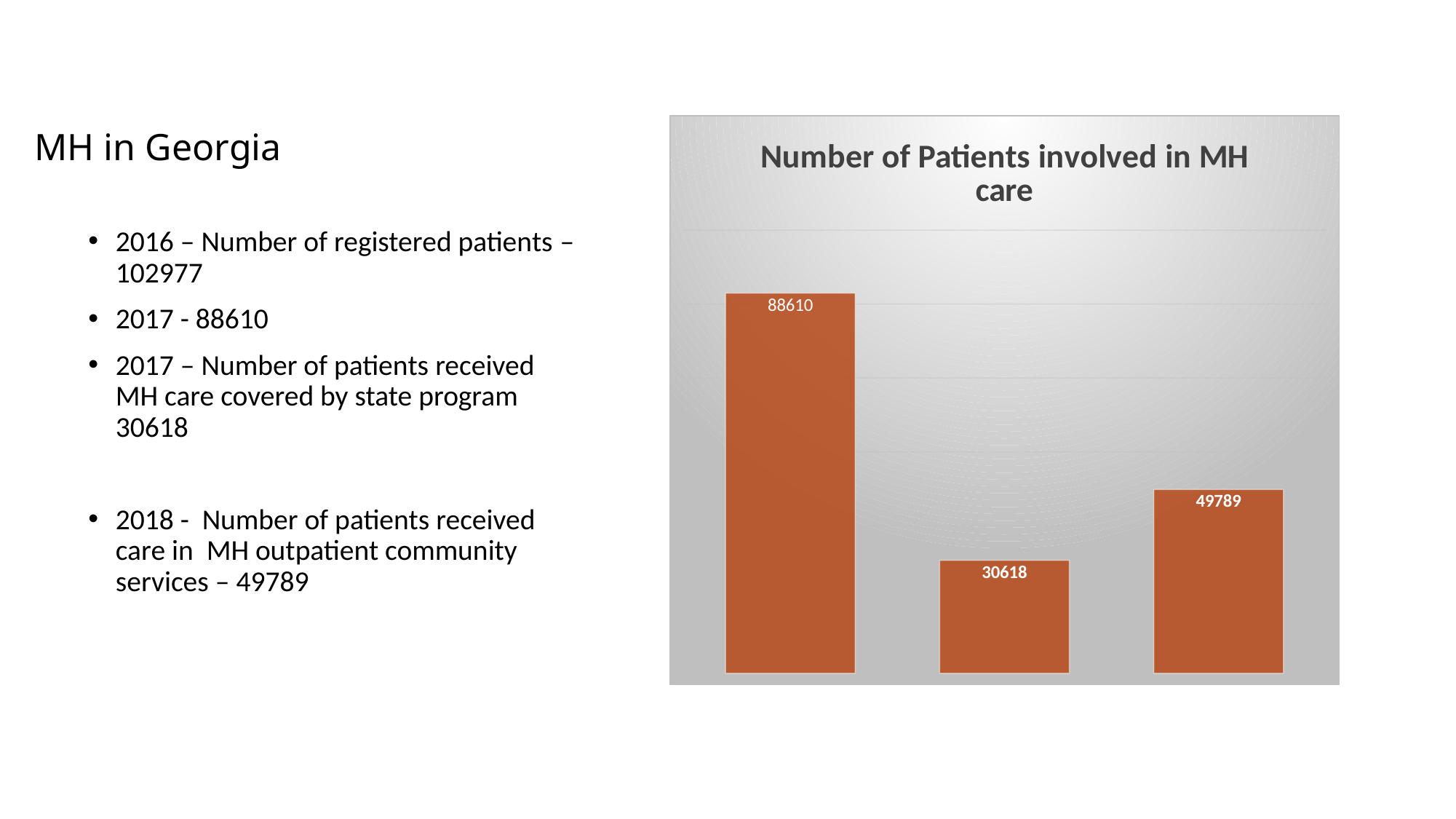
What is the value shown on the rightmost bar of the chart? 49789 What is the difference between the rightmost bar's value and the middle bar's value? 19171 How many bars are plotted in the chart? 3 What is the value shown on the first (leftmost) bar of the chart? 88610 What type of chart is shown on the slide? Bar chart What colour are the bars in the chart? Orange-brown Which bar has the lowest value in the chart? The middle bar (30618) What is the title of the chart? Number of Patients involved in MH care Which is larger, the value of the middle bar or the value of the rightmost bar? The rightmost bar (49789) Which bar has the highest value in the chart? The leftmost bar (88610) What is the difference between the leftmost bar's value and the middle bar's value? 57992 What is the value shown on the middle bar of the chart? 30618